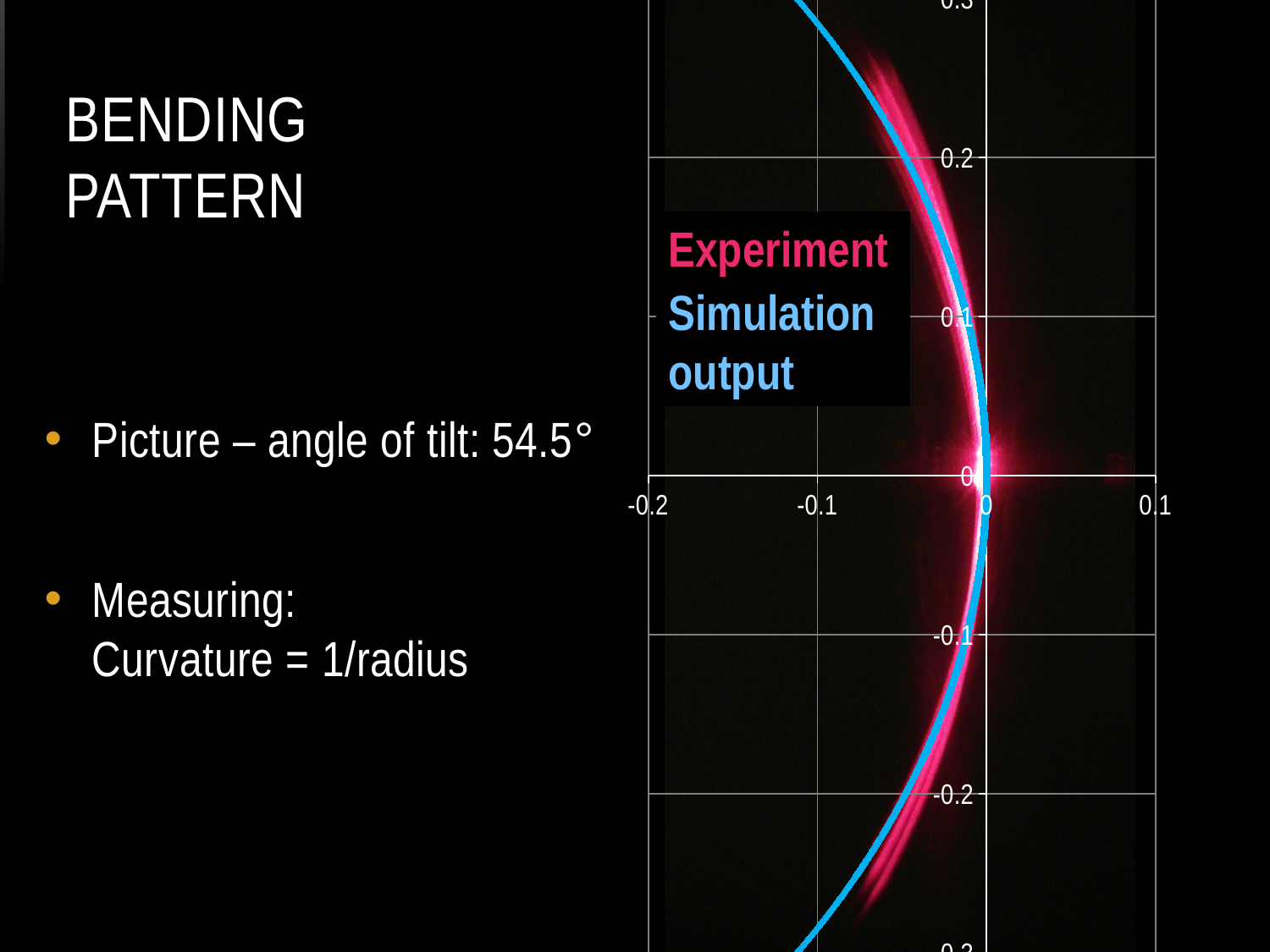
What kind of chart is shown on the right of the slide? line chart How many tick labels are shown on the chart's x axis? 4 What are the two series named in the chart's legend? Experiment and Simulation output At y = -0.2, is the x value of the Simulation output curve greater or less than 0? less As y increases from -0.2 to 0, does the x value of the Simulation output curve rise or fall? rise How many series does the legend on the chart list? 2 At y = 0.2, is the x value of the Simulation output curve greater or less than -0.1? greater What colour is the Simulation output series drawn in? blue What is the highest value labelled on the chart's x axis? 0.1 What is the lowest value labelled on the chart's x axis? -0.2 As y increases from 0 to 0.2, does the x value of the Simulation output curve rise or fall? fall At y = 0, what x value does the Simulation output curve pass through? 0